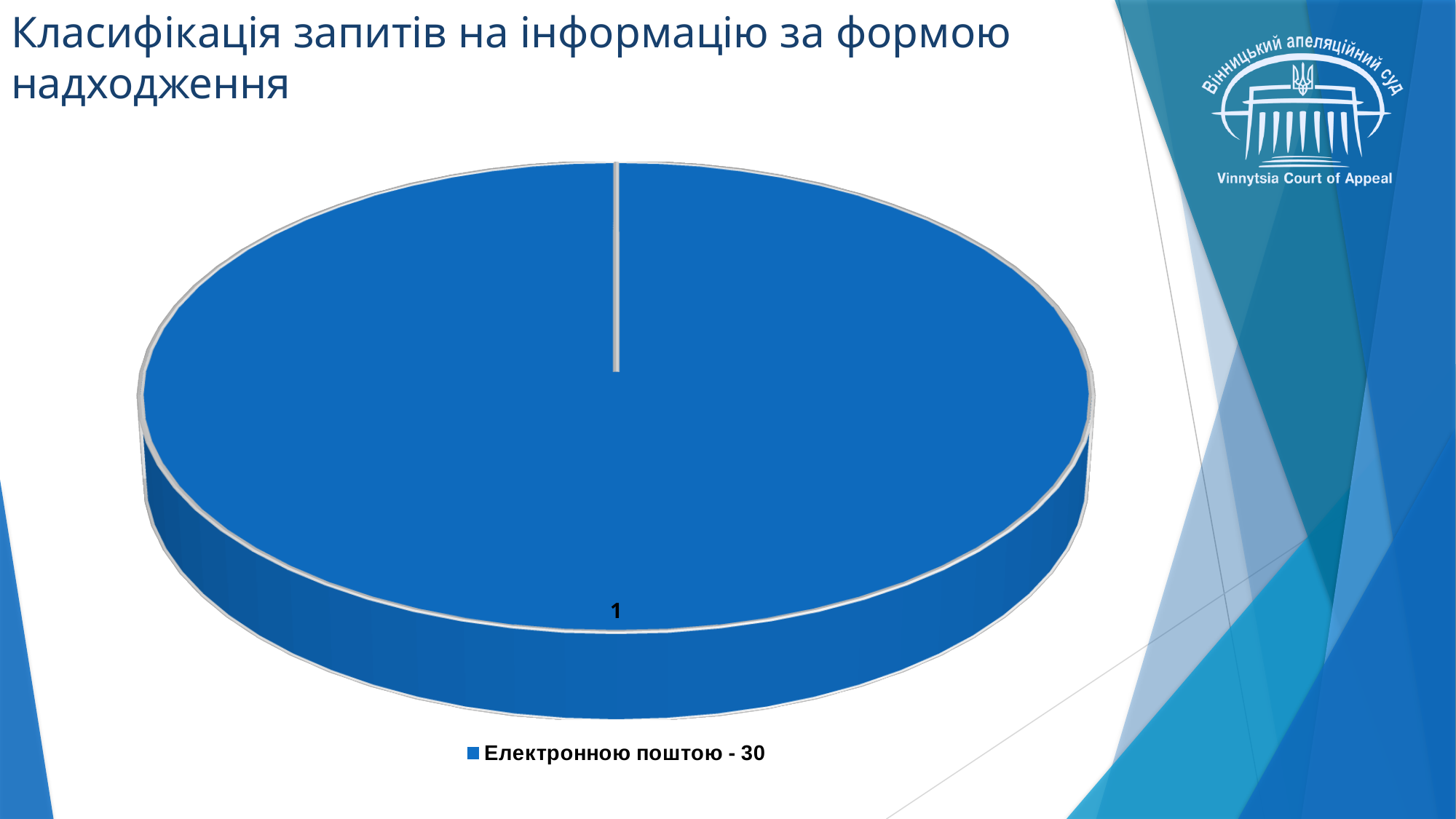
What kind of chart is shown on the slide? pie chart What data label is printed on the pie slice? 1 What is the title of the slide containing the pie chart? Класифікація запитів на інформацію за формою надходження What number is given for "Електронною поштою" in the legend? 30 How many slices does the pie chart have? 1 How many entries does the legend of the pie chart list? 1 What is the legend entry shown below the pie chart? Електронною поштою - 30